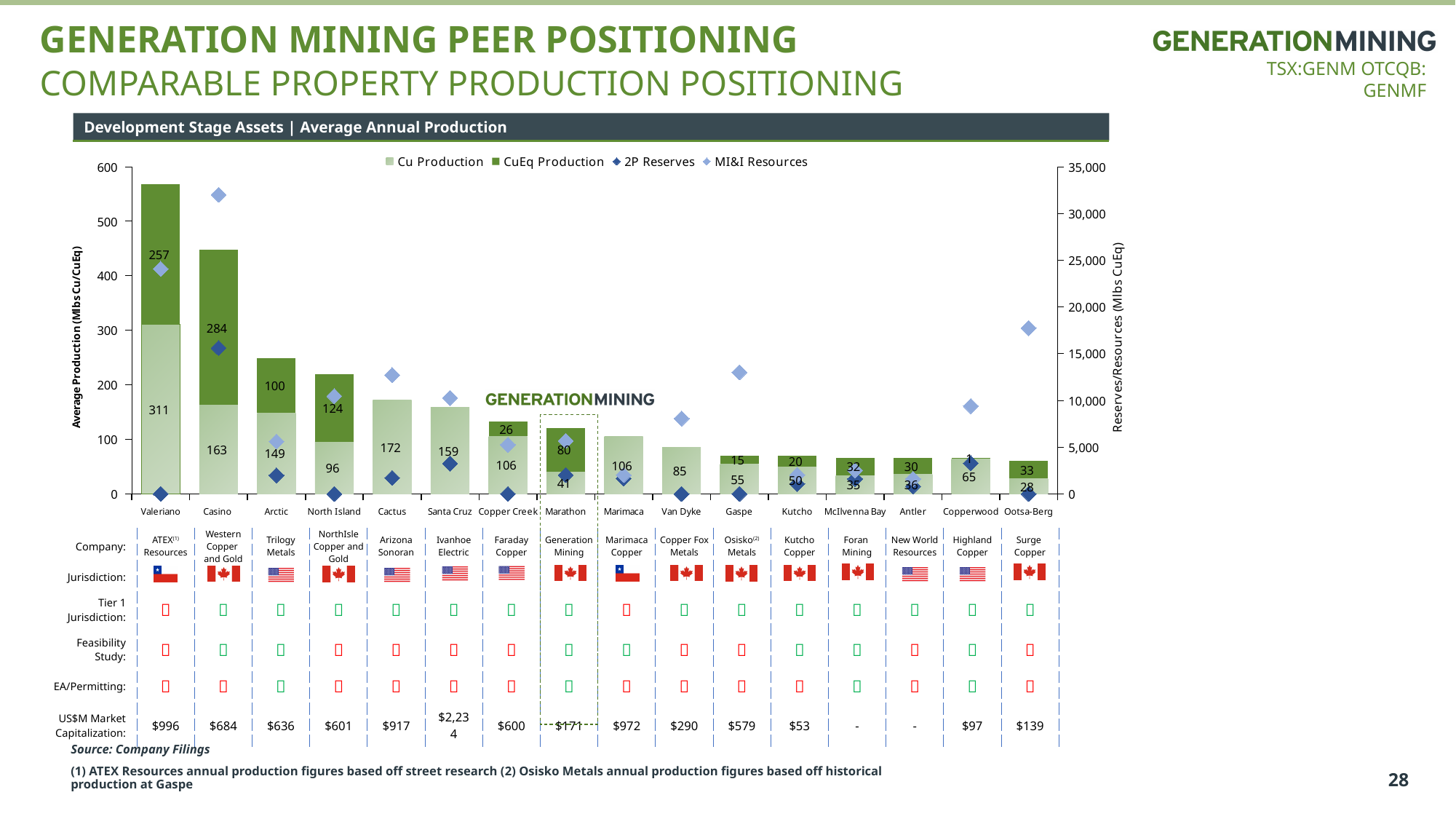
What is the CuEq Production value for Casino? 284 Which category has the lowest Cu Production? Ootsa-Berg Which has the larger Cu Production, Arctic or Casino? Casino Is the MI&I Resources value for Casino greater or less than 30,000? greater What is the total height of the stacked bar for Valeriano (Cu Production plus CuEq Production)? 568 Which category has the highest Cu Production? Valeriano How many series does the chart legend list? 4 What is the difference in Cu Production between Cactus and Santa Cruz? 13 What is the Cu Production value for Valeriano? 311 How many companies/projects are shown on the x axis of the chart? 16 What is the Cu Production value for Marathon? 41 Do the total production bars generally rise or fall from left to right along the x axis? fall